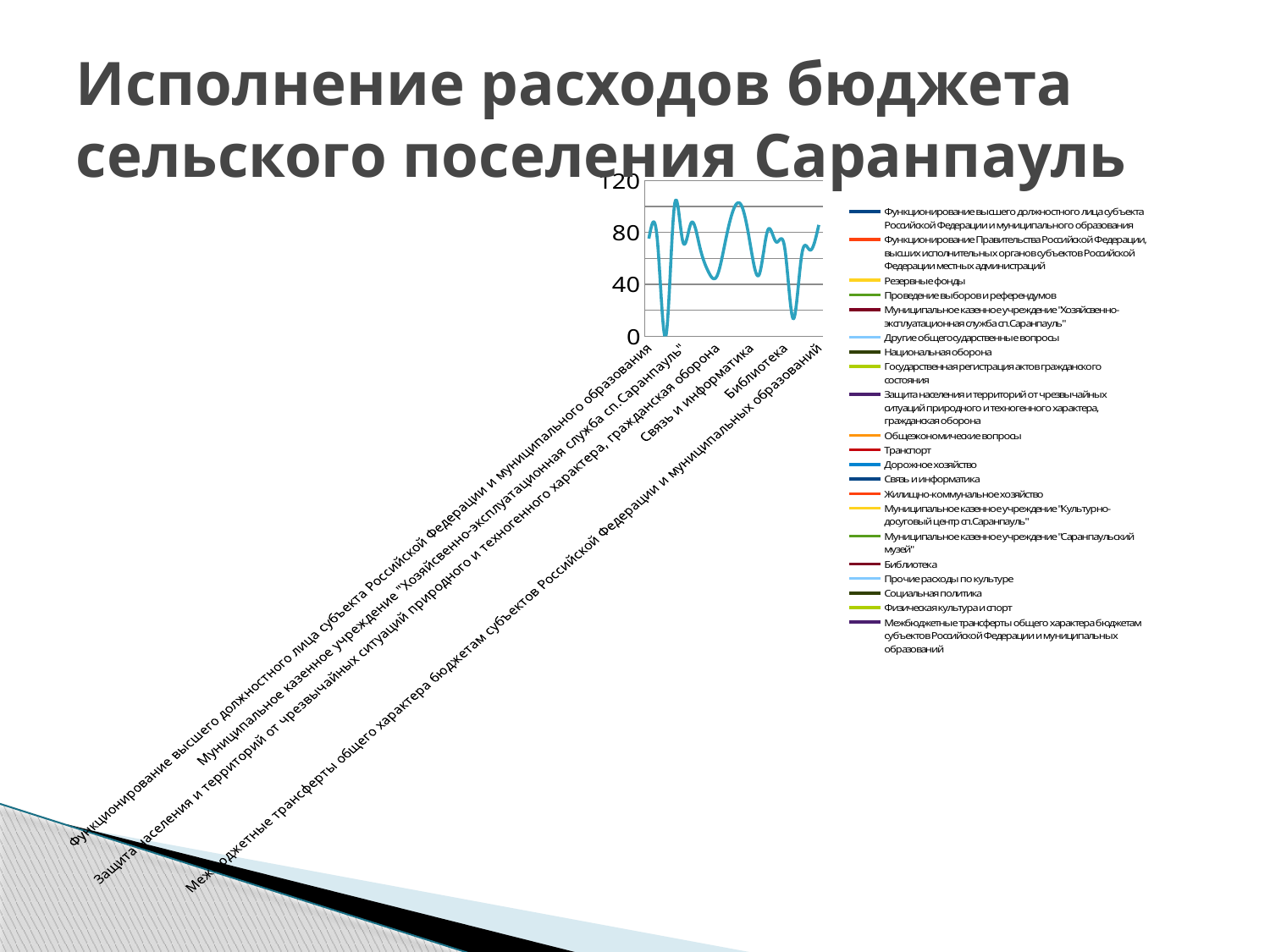
Is the value for "Межбюджетные трансферты общего характера бюджетам субъектов Российской Федерации и муниципальных образований" greater or less than 40? greater What is the title of the slide containing the chart? Исполнение расходов бюджета сельского поселения Саранпауль How many category labels are printed along the x axis of the chart? 6 Which category label appears last on the x axis of the chart? Межбюджетные трансферты общего характера бюджетам субъектов Российской Федерации и муниципальных образований Is the value for "Функционирование высшего должностного лица субъекта Российской Федерации и муниципального образования" greater or less than 40? greater What is the highest value shown on the chart's y axis? 120 How many entries does the chart's legend list? 21 What kind of chart is shown on the slide? line chart